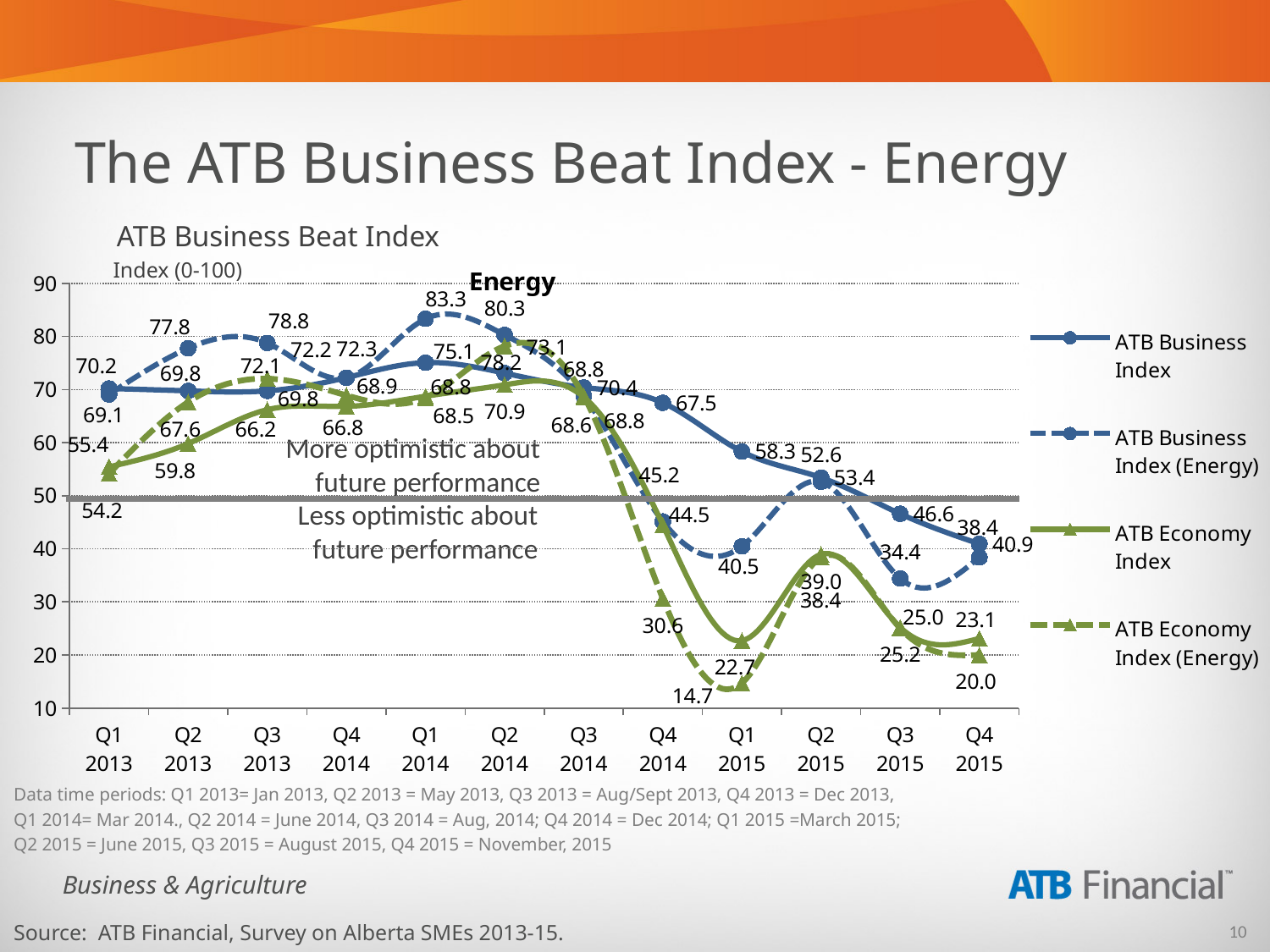
In which quarter does the ATB Business Index (Energy) reach its highest value? Q1 2014 How many quarters are plotted along the x axis? 12 What type of chart is shown on the slide? Line chart Is the value of the ATB Business Index (Energy) in Q1 2015 greater or less than 50? less What is the value of the ATB Business Index (Energy) in Q1 2014? 83.3 What is the value of the ATB Business Index (Energy) in Q2 2013? 77.8 In Q1 2014, which is larger: the ATB Business Index (Energy) or the ATB Business Index? ATB Business Index (Energy) Does the ATB Business Index rise or fall from Q4 2014 to Q4 2015? Fall In which quarter does the ATB Economy Index (Energy) reach its lowest value? Q1 2015 How many series does the legend list? 4 What is the difference between the ATB Business Index (Energy) in Q1 2014 (83.3) and in Q1 2015 (40.5)? 42.8 What is the value of the ATB Economy Index (Energy) in Q1 2015? 14.7